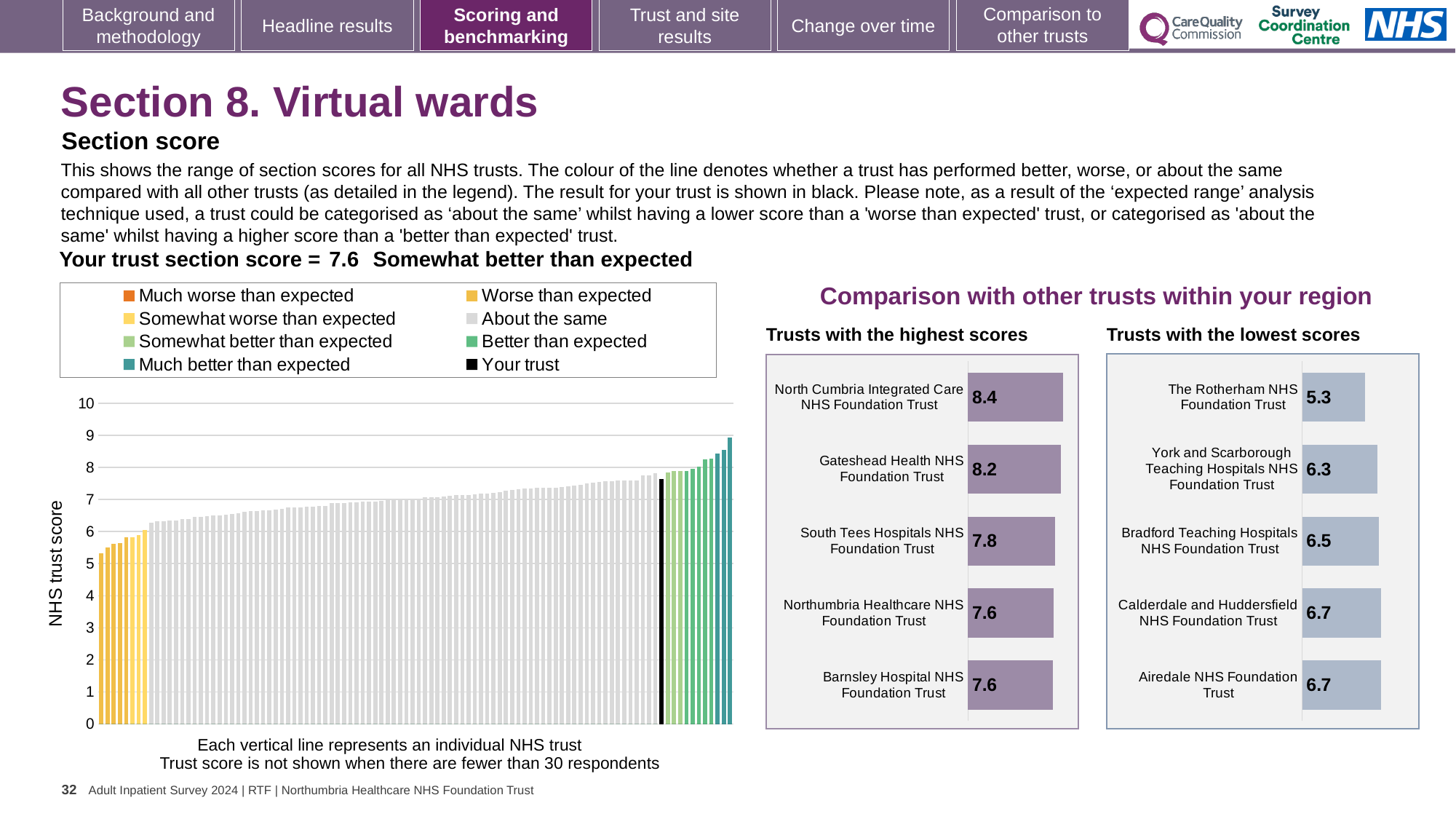
How many trusts are listed in the 'Trusts with the lowest scores' chart? 5 In the NHS trust score chart on the left, do the bar values rise or fall from left to right? rise In the 'Trusts with the highest scores' chart, what is the score for South Tees Hospitals NHS Foundation Trust? 7.8 How many entries does the legend of the NHS trust score chart on the left list? 8 In the 'Trusts with the lowest scores' chart, which trust has the lowest score? The Rotherham NHS Foundation Trust In the 'Trusts with the highest scores' chart, what is the score for North Cumbria Integrated Care NHS Foundation Trust? 8.4 In the 'Trusts with the highest scores' chart, which has the higher score: Gateshead Health NHS Foundation Trust or Barnsley Hospital NHS Foundation Trust? Gateshead Health NHS Foundation Trust In the 'Trusts with the highest scores' chart, what is the difference between the scores of North Cumbria Integrated Care NHS Foundation Trust and Gateshead Health NHS Foundation Trust? 0.2 In the NHS trust score chart on the left, is the value of the lowest bar greater or less than 5? greater In the NHS trust score chart on the left, what is the section score for your trust (the black bar)? 7.6 In the 'Trusts with the lowest scores' chart, what is the score for Bradford Teaching Hospitals NHS Foundation Trust? 6.5 In the 'Trusts with the lowest scores' chart, what is the difference between the scores of York and Scarborough Teaching Hospitals NHS Foundation Trust and The Rotherham NHS Foundation Trust? 1.0